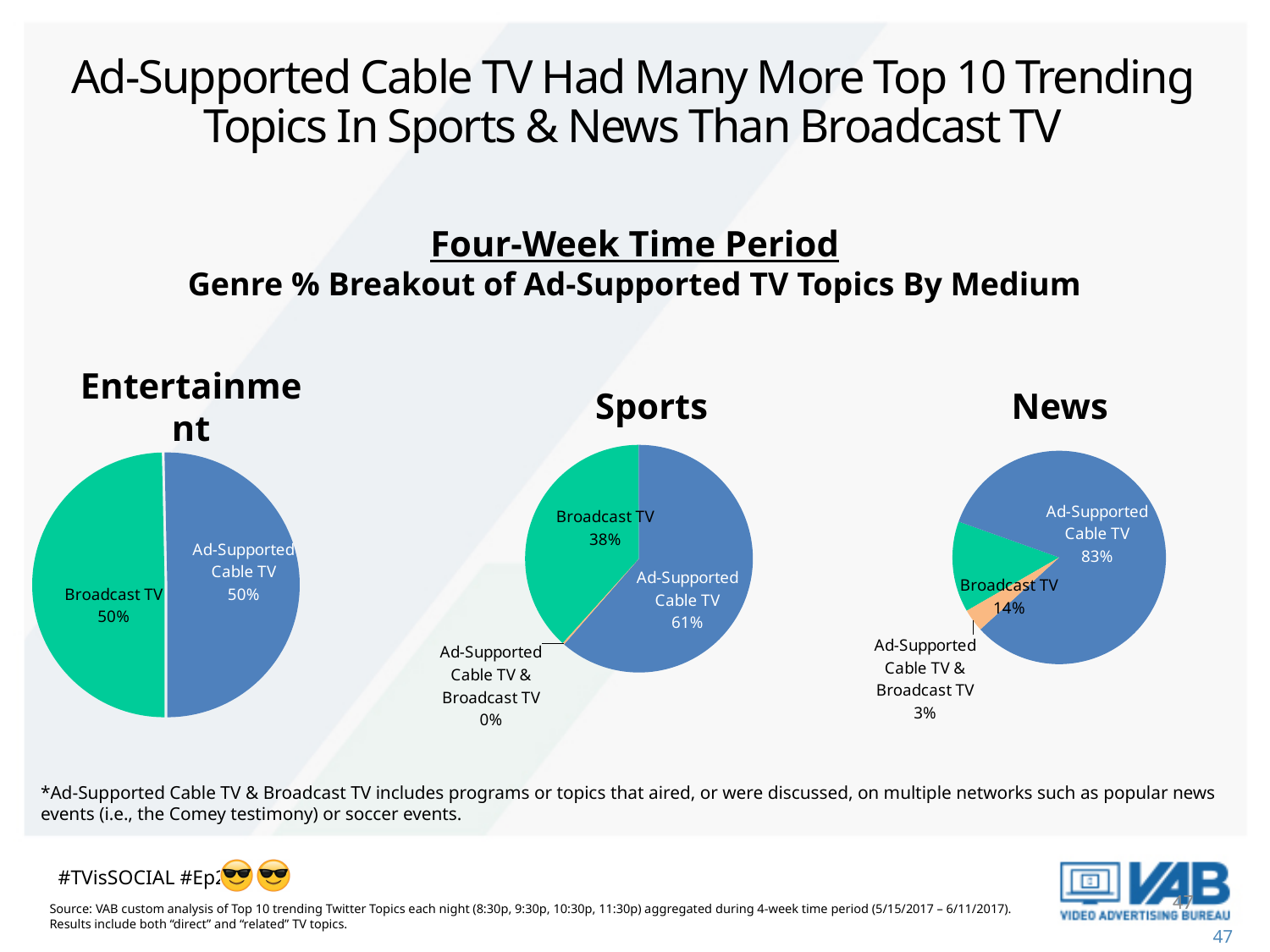
In the Sports pie chart, which slice is the largest? Ad-Supported Cable TV What type of chart is used for the Entertainment, Sports and News breakouts? Pie chart In the News pie chart, what share does Broadcast TV have? 14% In the Sports pie chart, what share does Ad-Supported Cable TV have? 61% How many pie charts are shown on the slide? 3 How many slices does the Sports pie chart have? 3 In the News pie chart, what share does Ad-Supported Cable TV & Broadcast TV have? 3% In the Entertainment pie chart, what share does Broadcast TV have? 50% In the News pie chart, which is larger: Ad-Supported Cable TV or Broadcast TV? Ad-Supported Cable TV In the News pie chart, which slice is the smallest? Ad-Supported Cable TV & Broadcast TV In the News pie chart, what is the difference between the Ad-Supported Cable TV share and the Broadcast TV share? 69 percentage points In the Sports pie chart, what is the difference between the Ad-Supported Cable TV share and the Broadcast TV share? 23 percentage points